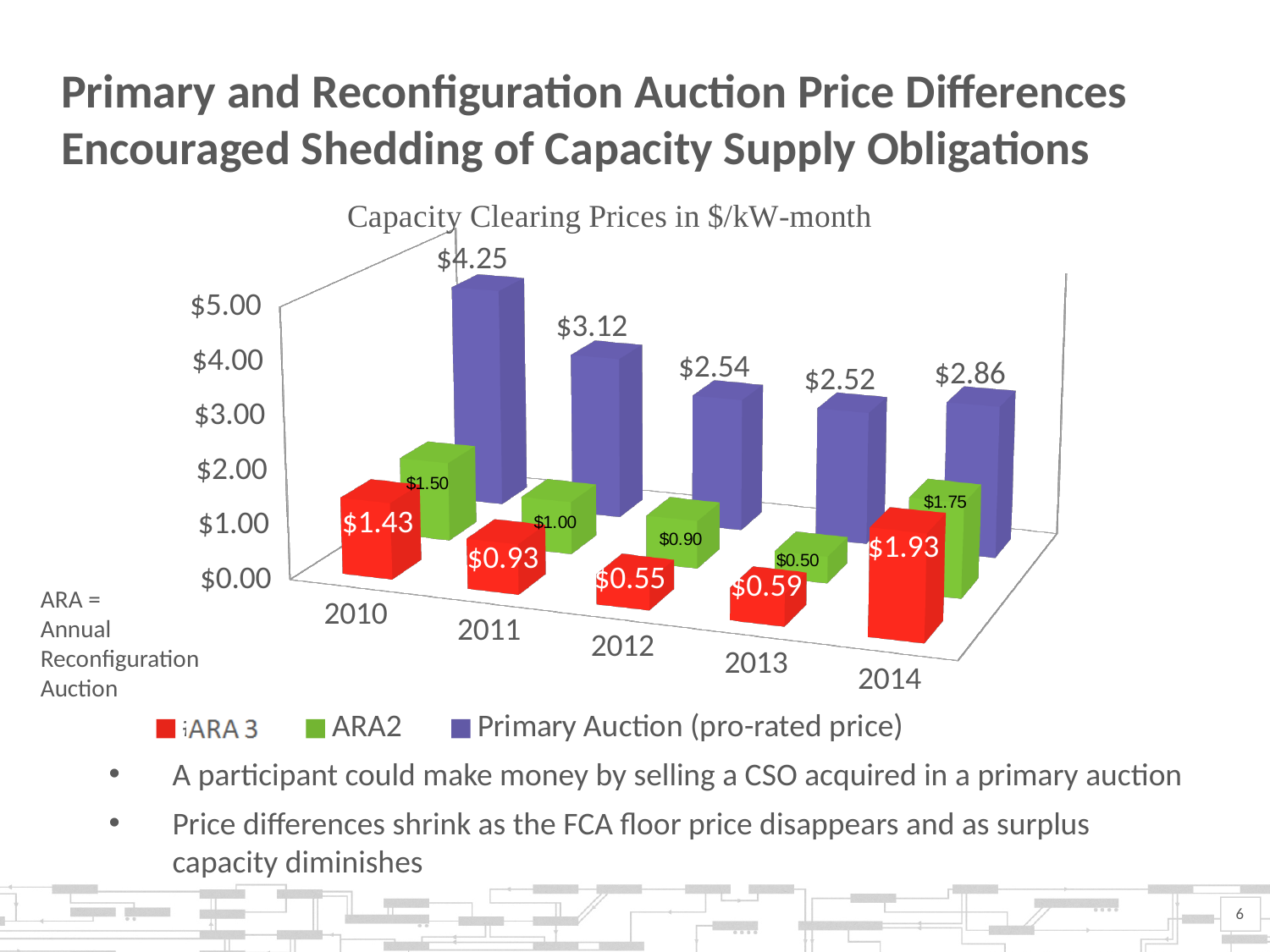
What is the ARA 3 value for 2011? $0.93 How many series does the legend list? 3 Which year has the highest Primary Auction (pro-rated price) value? 2010 What is the ARA2 value for 2012? $0.90 How many years are shown on the x axis? 5 What is the ARA 3 value for 2014? $1.93 What kind of chart is shown on the slide? Bar chart What is the difference between the Primary Auction (pro-rated price) and ARA 3 values in 2010? $2.82 Which is larger in 2013, the ARA 3 value or the ARA2 value? ARA 3 What is the title of the chart? Capacity Clearing Prices in $/kW-month What is the Primary Auction (pro-rated price) value for 2010? $4.25 Which year has the lowest ARA2 value? 2013